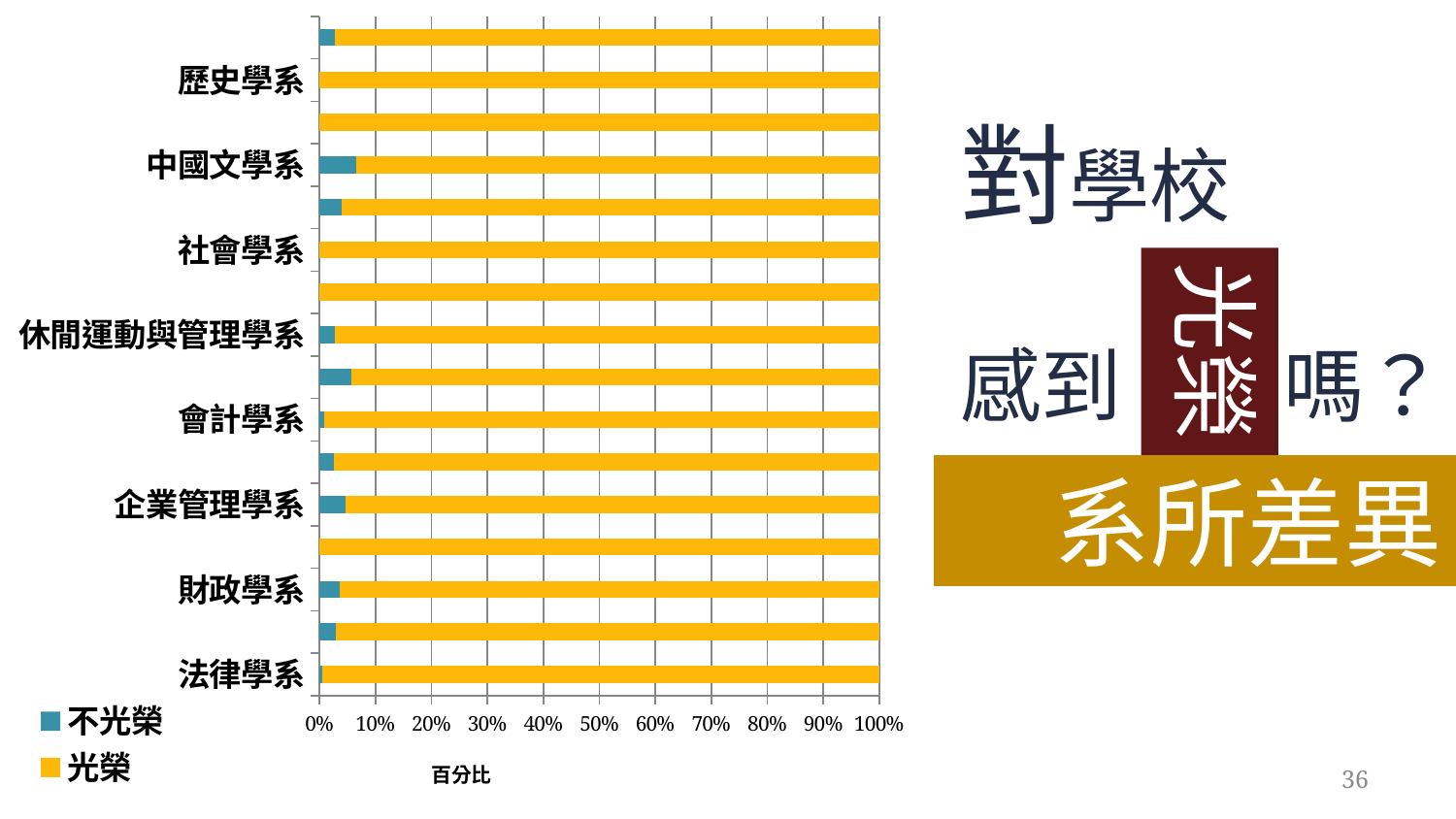
Is the 光榮 value for 歷史學系 greater or less than 90%? greater For 企業管理學系, which series is larger, 光榮 or 不光榮? 光榮 Is the 光榮 value for 法律學系 greater or less than 90%? greater What kind of chart is shown on the slide? Stacked bar chart What is the maximum value shown on the horizontal axis? 100% Is the 不光榮 value for 會計學系 greater or less than 10%? less What is the title of the horizontal axis? 百分比 How many series does the legend list? 2 What are the two series named in the legend? 不光榮 and 光榮 How many department labels are shown on the vertical axis? 8 For 財政學系, which series is larger, 不光榮 or 光榮? 光榮